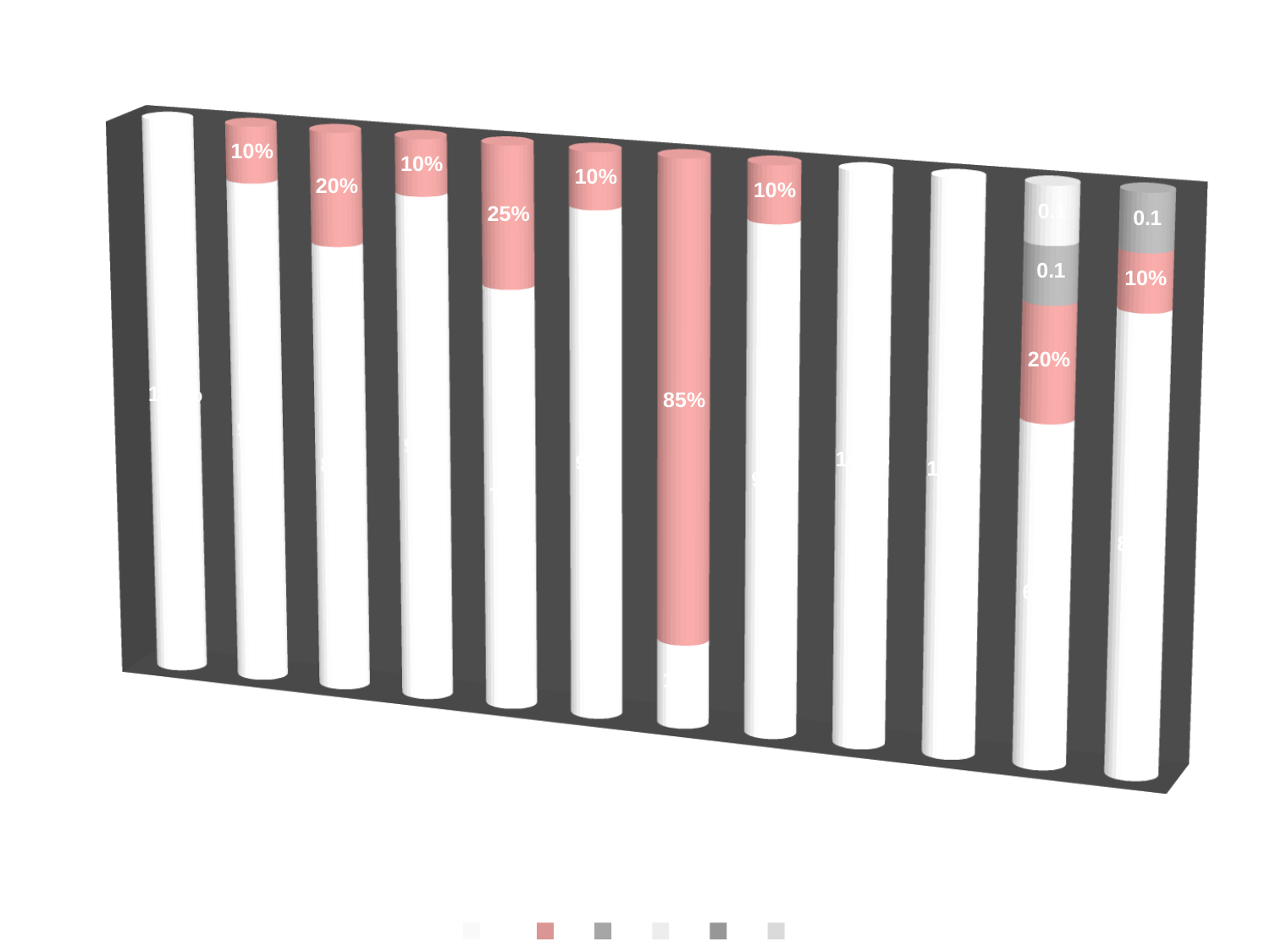
Which bar has the largest pink segment? the seventh bar from the left Is the pink segment on the fifth bar from the left larger or smaller than the pink segment on the third bar from the left? larger What is the value of the pink segment on the rightmost bar? 10% How many bars are plotted in the chart? 12 What is the value of the pink segment on the fifth bar from the left? 25% What is the value of the pink segment on the seventh bar from the left? 85% What is the difference between the pink segment on the seventh bar from the left (85%) and the pink segment on the eighth bar from the left (10%)? 75% What kind of chart is shown on the slide? bar chart What is the value of the pink segment on the third bar from the left? 20% How many series does the legend list? 6 What is the value of the topmost grey segment on the rightmost bar? 0.1 What is the value of the pink segment on the second bar from the left? 10%